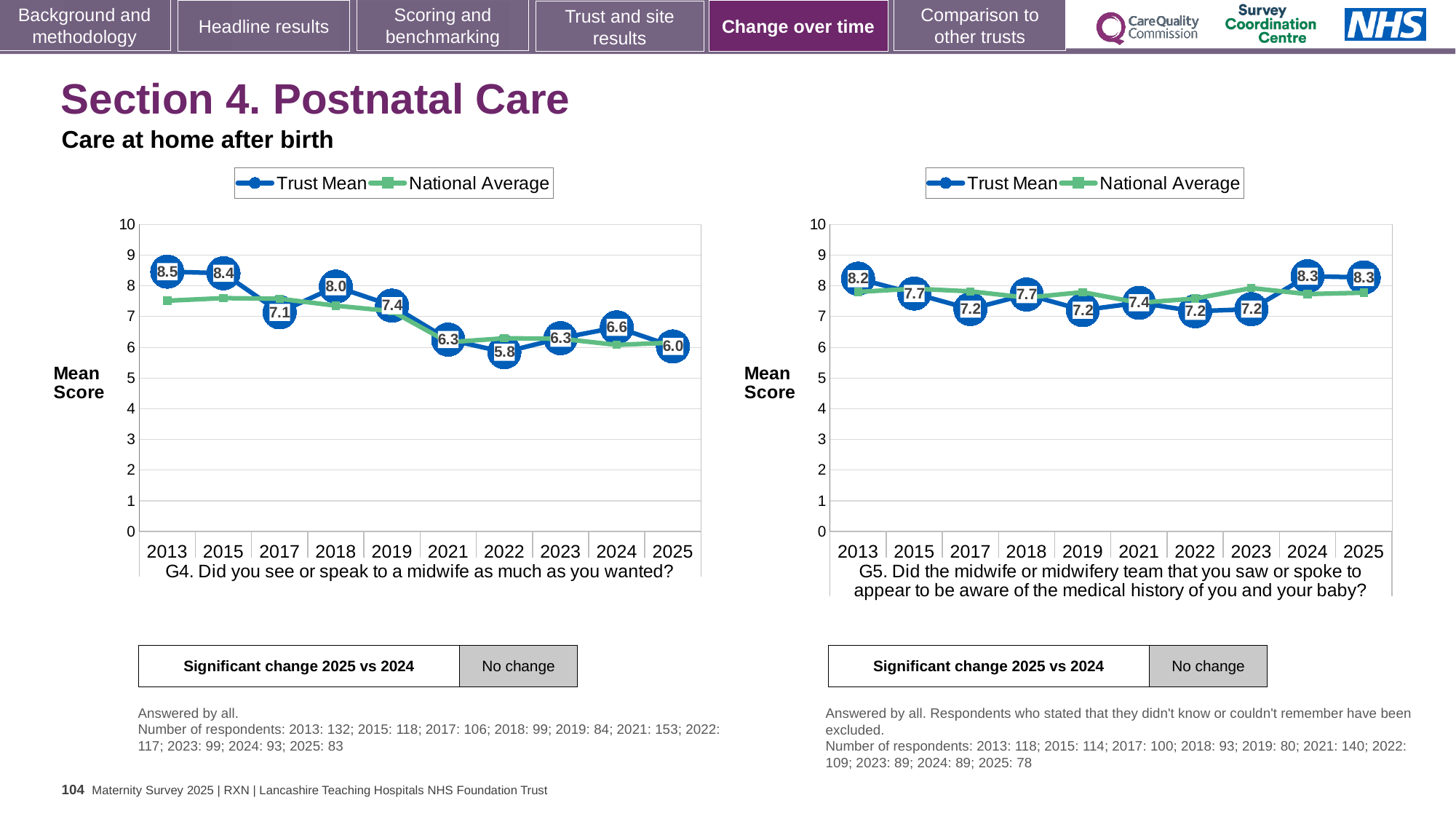
In the G4 chart (left), which year has the highest Trust Mean score? 2013 In the G5 chart (right), which is larger, the Trust Mean score for 2013 or for 2017? 2013 In the G4 chart (left), what is the Trust Mean score for 2022? 5.8 In the G4 chart (left), which year has the lowest Trust Mean score? 2022 In the G4 chart (left), is the National Average value for 2013 greater or less than 8? less How many series does the legend of the G4 chart (left) list? 2 In the G4 chart (left), what is the Trust Mean score for 2013? 8.5 In the G4 chart (left), what is the difference between the Trust Mean scores for 2013 and 2025? 2.5 In the G5 chart (right), what is the Trust Mean score for 2021? 7.4 What type of chart is the G5 chart (right)? Line chart How many years are plotted on the x axis of the G5 chart (right)? 10 In the G5 chart (right), what is the Trust Mean score for 2024? 8.3